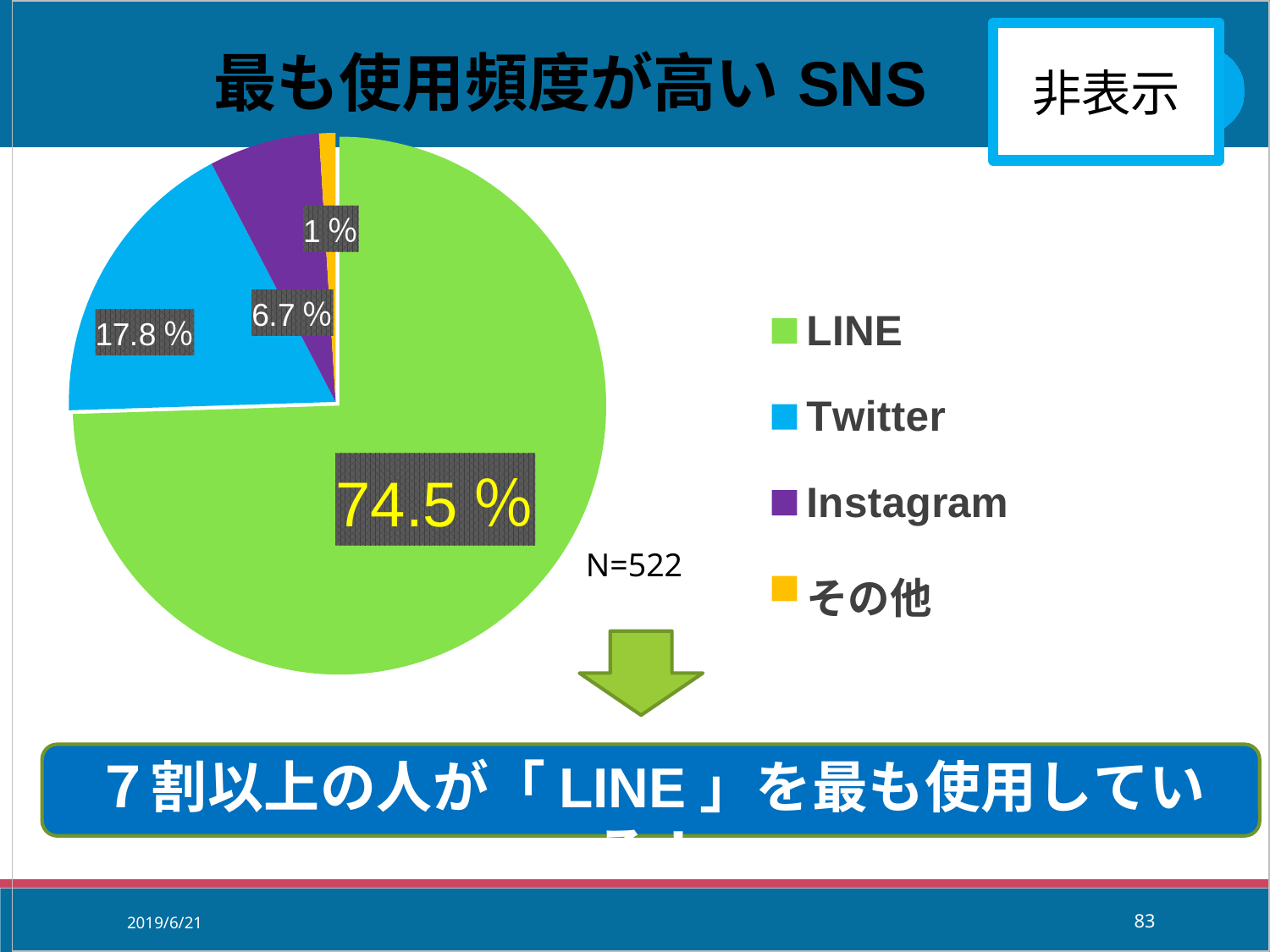
What is the difference in percentage points between the LINE slice and the Twitter slice? 56.7 What share of the pie does Instagram account for? 6.7 % How many categories are shown in the pie chart? 4 Which category has the smallest slice of the pie? その他 What share of the pie does その他 account for? 1 % What kind of chart is shown on the slide? Pie chart What share of the pie does LINE account for? 74.5 % Which slice is larger, Twitter or Instagram? Twitter What share of the pie does Twitter account for? 17.8 % What sample size (N) is shown next to the pie chart? N=522 What is the title of the chart? 最も使用頻度が高い SNS Which category has the largest slice of the pie? LINE